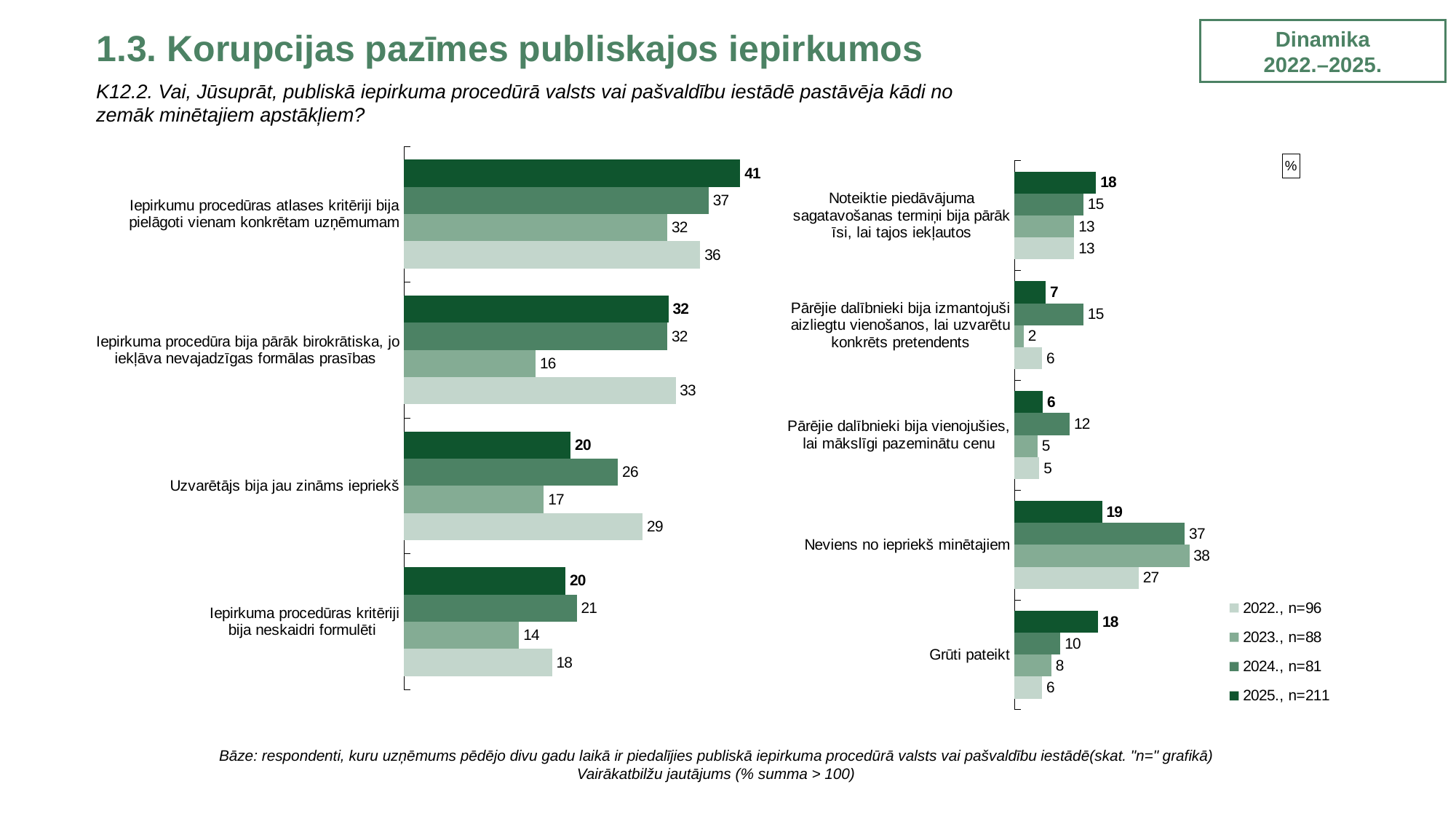
How many categories does the right chart show? 5 In the left chart, what is the 2023 value for "Iepirkuma procedūra bija pārāk birokrātiska, jo iekļāva nevajadzīgas formālas prasības"? 16 In the left chart, what is the difference between the 2022 and 2025 values for "Uzvarētājs bija jau zināms iepriekš"? 9 How many series does the legend list? 4 In the right chart, which category has the lowest 2023 value? Pārējie dalībnieki bija izmantojuši aizliegtu vienošanos, lai uzvarētu konkrēts pretendents In the left chart, which category has the highest 2025 value? Iepirkumu procedūras atlases kritēriji bija pielāgoti vienam konkrētam uzņēmumam According to the legend, what is the sample size (n) for 2025? 211 In the right chart, which is larger for "Neviens no iepriekš minētajiem": the 2024 value or the 2025 value? 2024 In the left chart, what is the 2025 value for "Iepirkumu procedūras atlases kritēriji bija pielāgoti vienam konkrētam uzņēmumam"? 41 In the right chart, what is the 2022 value for "Neviens no iepriekš minētajiem"? 27 What type of chart is the left chart? Bar chart In the right chart, what is the 2025 value for "Grūti pateikt"? 18